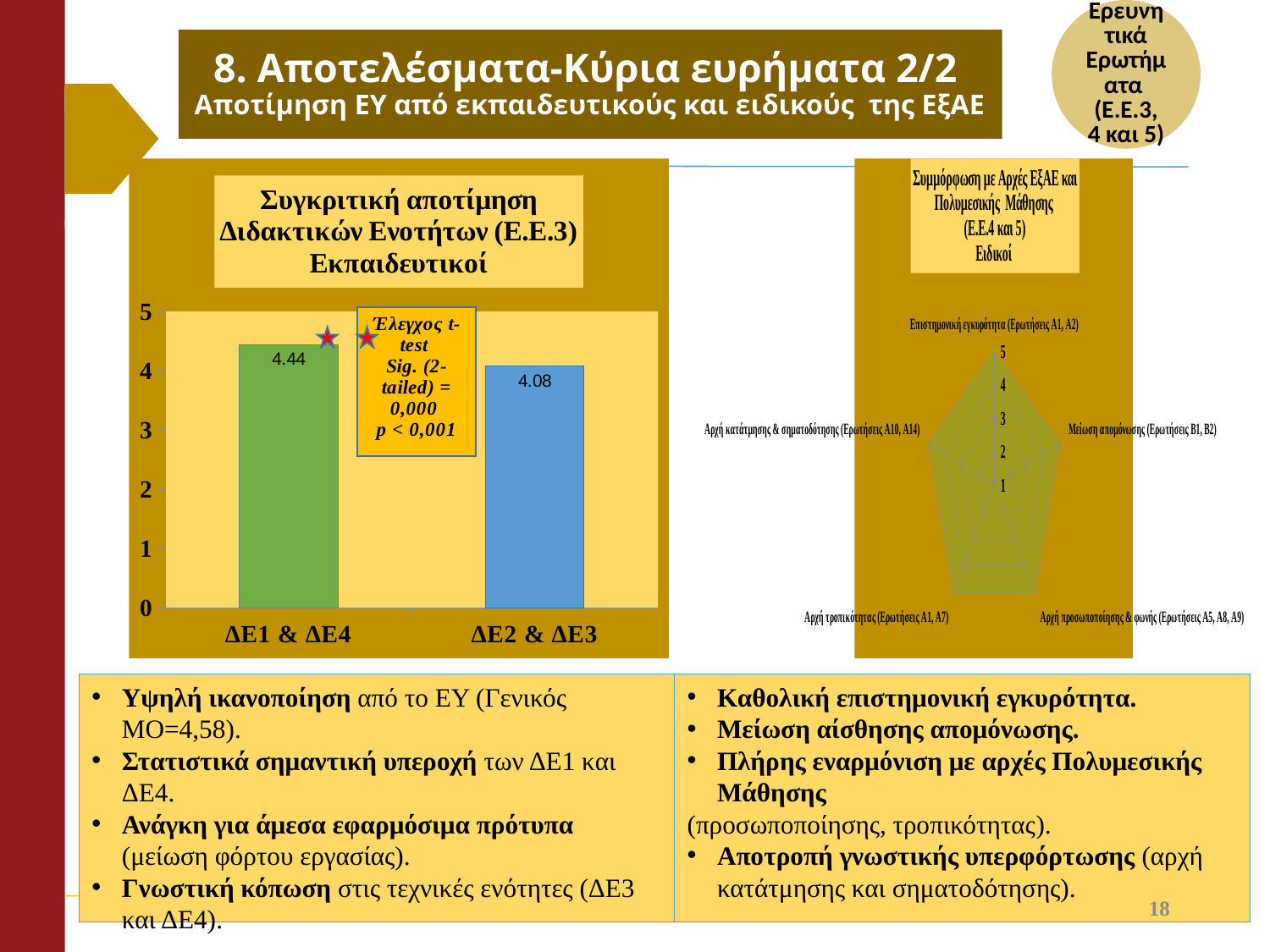
In the bar chart on the left, which is larger: the value for ΔΕ1 & ΔΕ4 or the value for ΔΕ2 & ΔΕ3? ΔΕ1 & ΔΕ4 What kind of chart is the chart on the right of the slide? Radar chart In the radar chart on the right, is the value for Επιστημονική εγκυρότητα (Ερωτήσεις Α1, Α2) greater or less than 3? greater In the bar chart on the left, is the value for ΔΕ2 & ΔΕ3 greater or less than 4? greater In the bar chart on the left, how many categories are shown on the x axis? 2 In the radar chart on the right, how many axes (categories) are shown? 5 What kind of chart is the chart on the left of the slide? Bar chart In the bar chart on the left, which category has the highest value? ΔΕ1 & ΔΕ4 In the bar chart on the left, what is the difference between the values for ΔΕ1 & ΔΕ4 and ΔΕ2 & ΔΕ3? 0.36 In the bar chart on the left, what is the value for ΔΕ1 & ΔΕ4? 4.44 In the bar chart on the left, which category has the lowest value? ΔΕ2 & ΔΕ3 In the bar chart on the left, what is the value for ΔΕ2 & ΔΕ3? 4.08